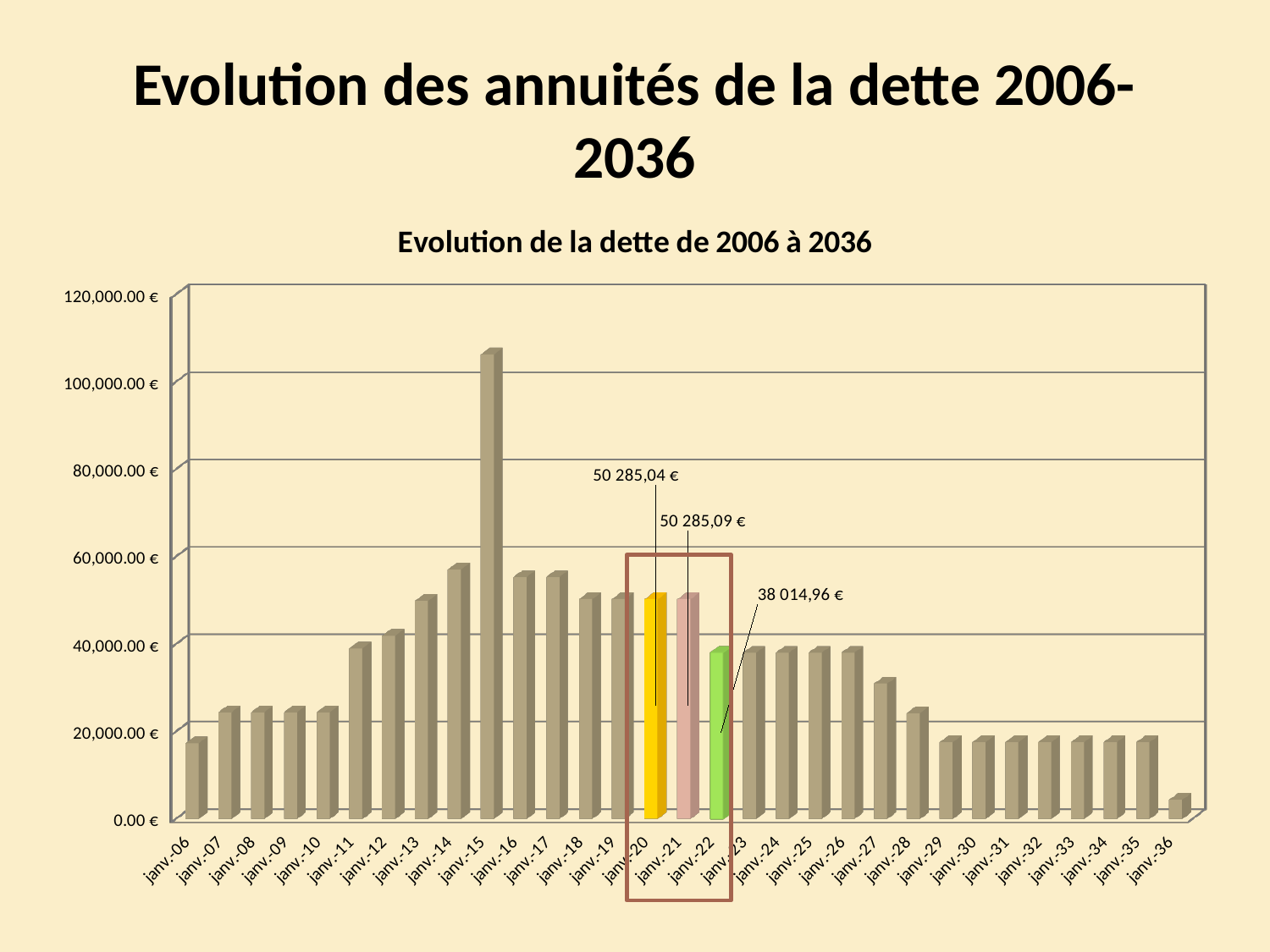
Which year has the lowest bar? janv.-36 What is the value for janv.-20? 50 285,04 € How many years are shown on the x axis? 31 Which year has the highest bar? janv.-15 What is the value for janv.-22? 38 014,96 € What is the title of the chart? Evolution de la dette de 2006 à 2036 Which is larger, the value for janv.-20 or the value for janv.-22? janv.-20 What is the value for janv.-21? 50 285,09 € Is the value for janv.-15 greater or less than 100,000.00 €? greater Is the value for janv.-06 greater or less than 20,000.00 €? less What is the difference between the values for janv.-21 and janv.-22? 12 270,13 € What kind of chart is shown on the slide? Bar chart